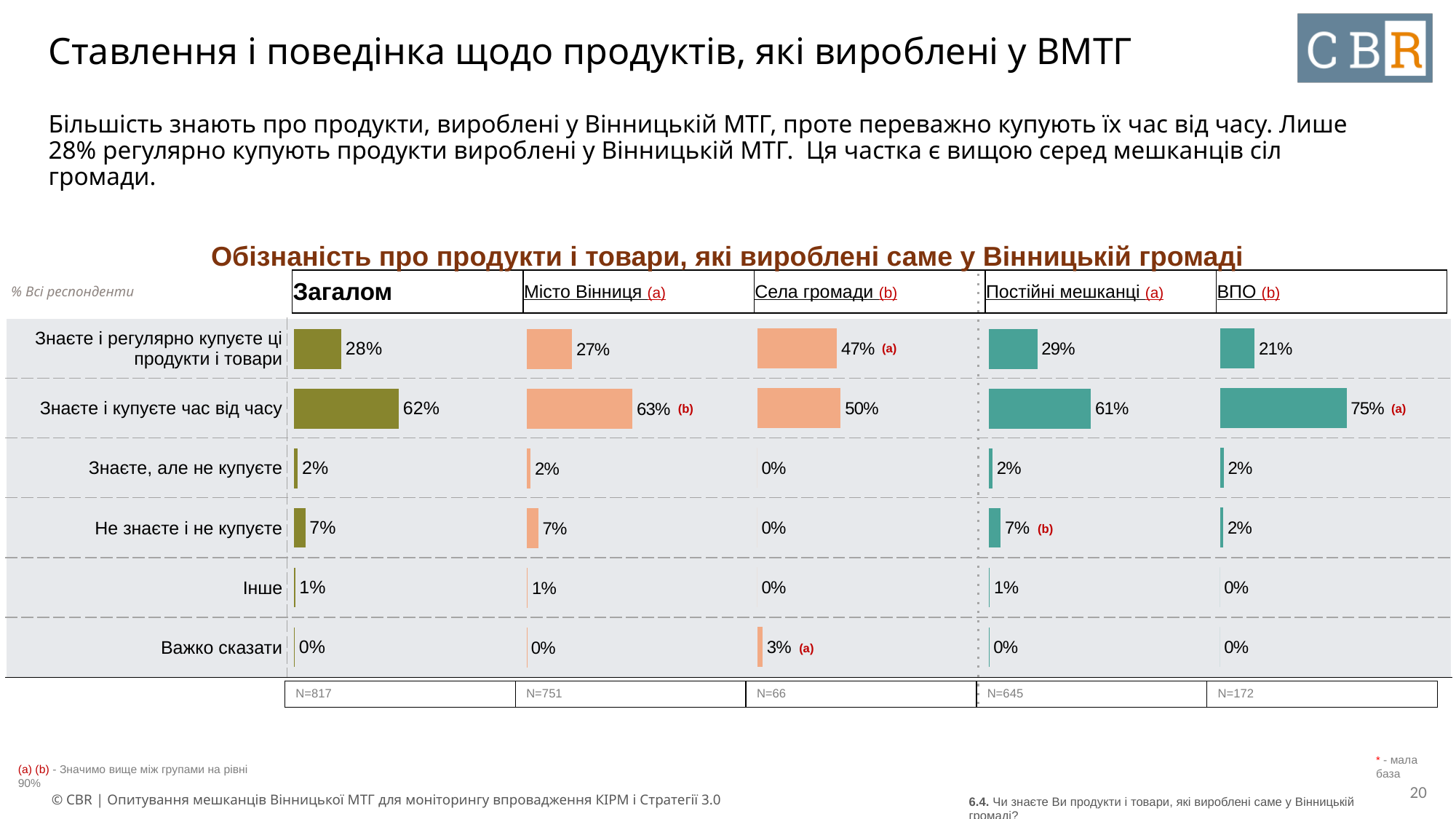
In the 'Села громади (b)' column, what is the value for 'Знаєте і регулярно купуєте ці продукти і товари'? 47% In the 'Постійні мешканці (a)' column, what is the value for 'Не знаєте і не купуєте'? 7% In the 'ВПО (b)' column, what is the value for 'Знаєте і купуєте час від часу'? 75% What type of chart is used on this slide? Bar chart How many response categories are listed in the chart? 6 For 'Знаєте і регулярно купуєте ці продукти і товари', which is larger: the value for 'Місто Вінниця (a)' or for 'Села громади (b)'? Села громади (b) What is the sample size (N) shown for the 'Села громади (b)' column? N=66 In the 'Загалом' column, what percentage of respondents know and regularly buy products made in the Vinnytsia community? 28% How many respondent groups (columns) does the chart show? 5 In the 'Місто Вінниця (a)' column, which response category has the lowest value? Важко сказати In the 'Загалом' column, which response category has the highest value? Знаєте і купуєте час від часу What is the difference between the 'Знаєте і купуєте час від часу' values for 'ВПО (b)' and 'Постійні мешканці (a)'? 14%